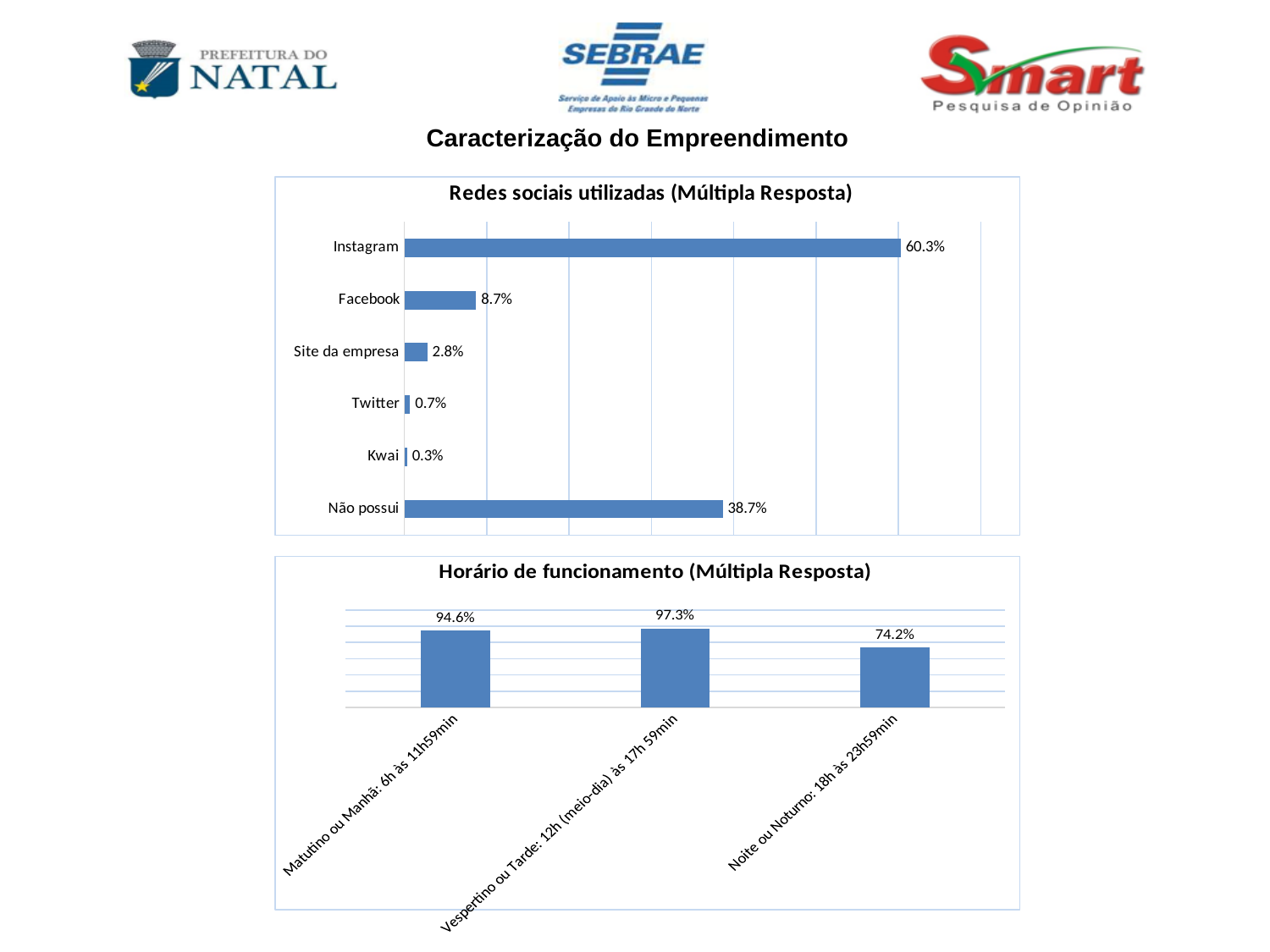
In the 'Redes sociais utilizadas (Múltipla Resposta)' chart, what is the value for Facebook? 8.7% In the 'Redes sociais utilizadas (Múltipla Resposta)' chart, what is the difference between Instagram and Não possui? 21.6% In the 'Redes sociais utilizadas (Múltipla Resposta)' chart, which category has the lowest value? Kwai In the 'Horário de funcionamento (Múltipla Resposta)' chart, which category has the lowest value? Noite ou Noturno: 18h às 23h59min What kind of chart is 'Redes sociais utilizadas (Múltipla Resposta)'? Bar chart In the 'Horário de funcionamento (Múltipla Resposta)' chart, what is the value for 'Vespertino ou Tarde: 12h (meio-dia) às 17h 59min'? 97.3% In the 'Redes sociais utilizadas (Múltipla Resposta)' chart, which category has the highest value? Instagram In the 'Horário de funcionamento (Múltipla Resposta)' chart, what is the value for 'Noite ou Noturno: 18h às 23h59min'? 74.2% In the 'Redes sociais utilizadas (Múltipla Resposta)' chart, what is the value for Instagram? 60.3% In the 'Redes sociais utilizadas (Múltipla Resposta)' chart, how many categories are shown? 6 In the 'Redes sociais utilizadas (Múltipla Resposta)' chart, which is larger, Site da empresa or Twitter? Site da empresa In the 'Horário de funcionamento (Múltipla Resposta)' chart, what is the difference between 'Vespertino ou Tarde' and 'Matutino ou Manhã'? 2.7%